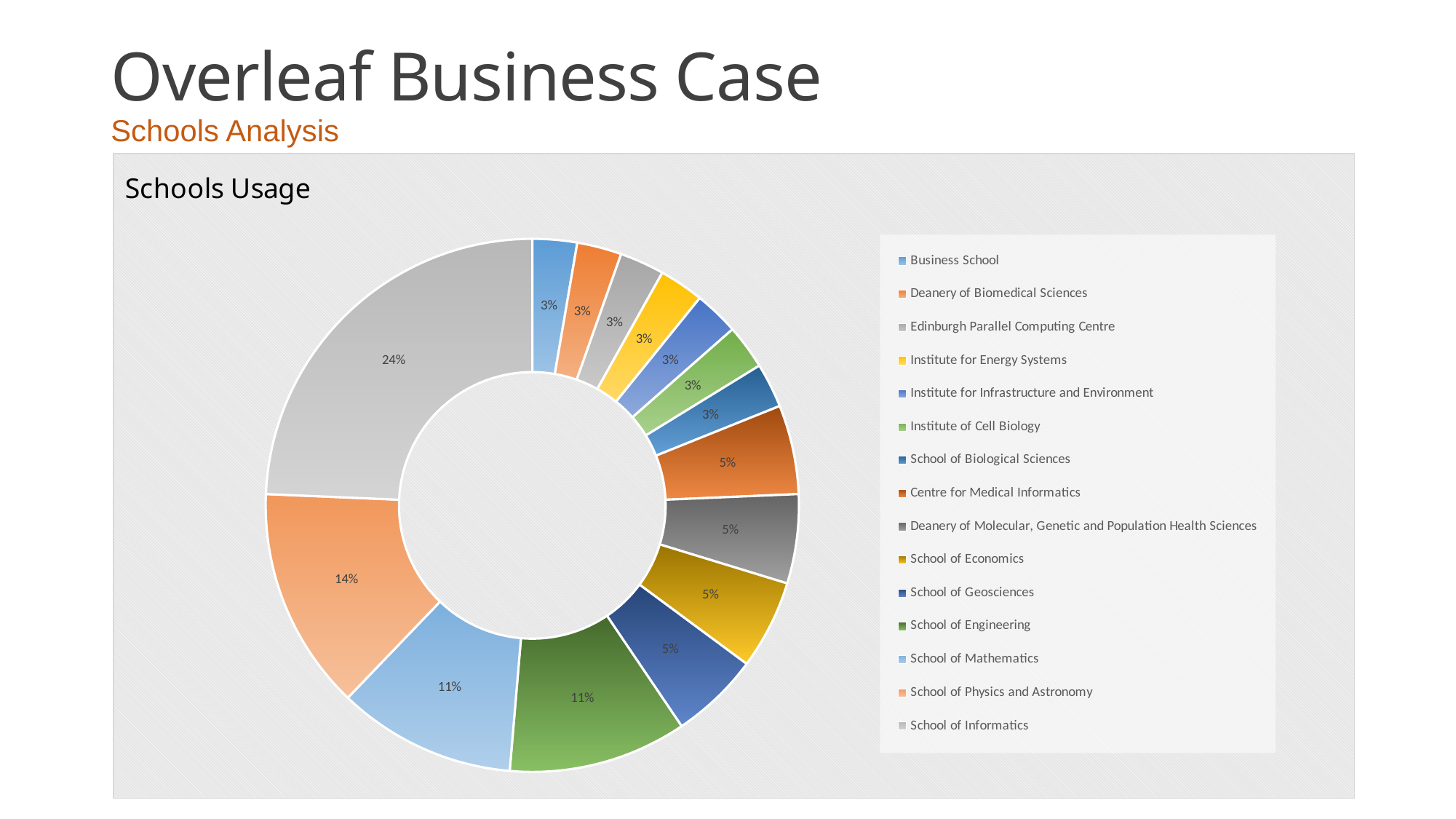
What is the title of the chart on the slide? Schools Usage How many categories are listed in the legend of the Schools Usage chart? 15 Which has a larger share, the School of Geosciences or the Institute of Cell Biology? School of Geosciences What percentage is shown for the School of Physics and Astronomy in the Schools Usage chart? 14% What percentage is shown for the Business School in the Schools Usage chart? 3% What share of the Schools Usage chart does the School of Informatics account for? 24% What percentage is shown for the School of Engineering in the Schools Usage chart? 11% Which school has the largest share in the Schools Usage chart? School of Informatics What is the difference in percentage points between the School of Informatics and the School of Physics and Astronomy? 10 What percentage is shown for the Centre for Medical Informatics in the Schools Usage chart? 5% What type of chart is the Schools Usage chart? Doughnut chart Which has a larger share in the Schools Usage chart, the School of Mathematics or the School of Economics? School of Mathematics